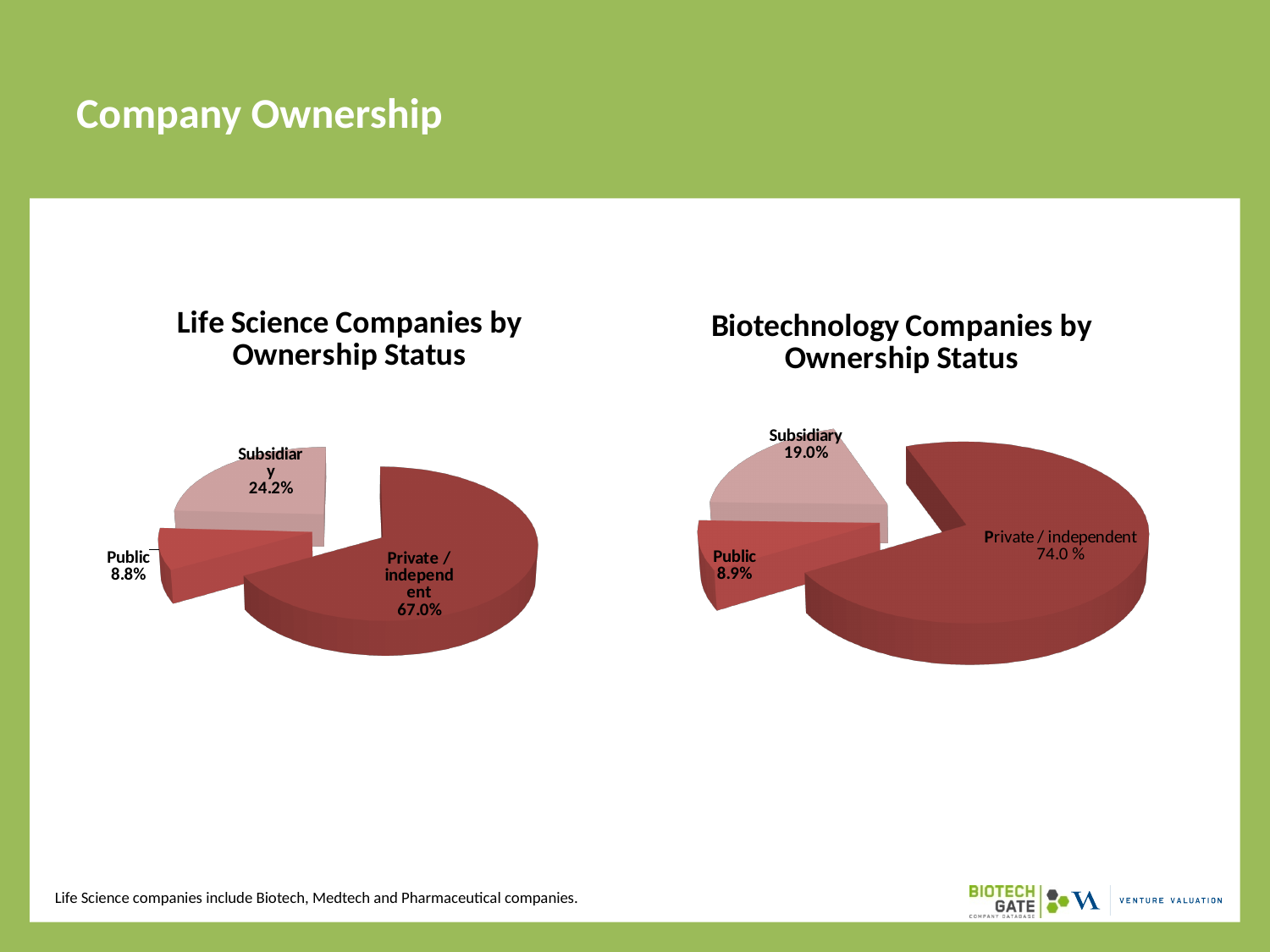
In the 'Life Science Companies by Ownership Status' chart, what share is Private / independent? 67.0% In the 'Life Science Companies by Ownership Status' chart, what share is Public? 8.8% In the 'Biotechnology Companies by Ownership Status' chart, which is larger, the Subsidiary share or the Public share? Subsidiary In the 'Life Science Companies by Ownership Status' chart, which ownership category has the largest share? Private / independent In the 'Biotechnology Companies by Ownership Status' chart, what share is Subsidiary? 19.0% In the 'Life Science Companies by Ownership Status' chart, what share is Subsidiary? 24.2% What kind of chart is the 'Biotechnology Companies by Ownership Status' chart? Pie chart In the 'Biotechnology Companies by Ownership Status' chart, which ownership category has the smallest share? Public In the 'Biotechnology Companies by Ownership Status' chart, what share is Public? 8.9% In the 'Biotechnology Companies by Ownership Status' chart, what share is Private / independent? 74.0 % How many slices does the 'Life Science Companies by Ownership Status' chart have? 3 In the 'Life Science Companies by Ownership Status' chart, what is the difference between the Subsidiary and Public shares? 15.4%